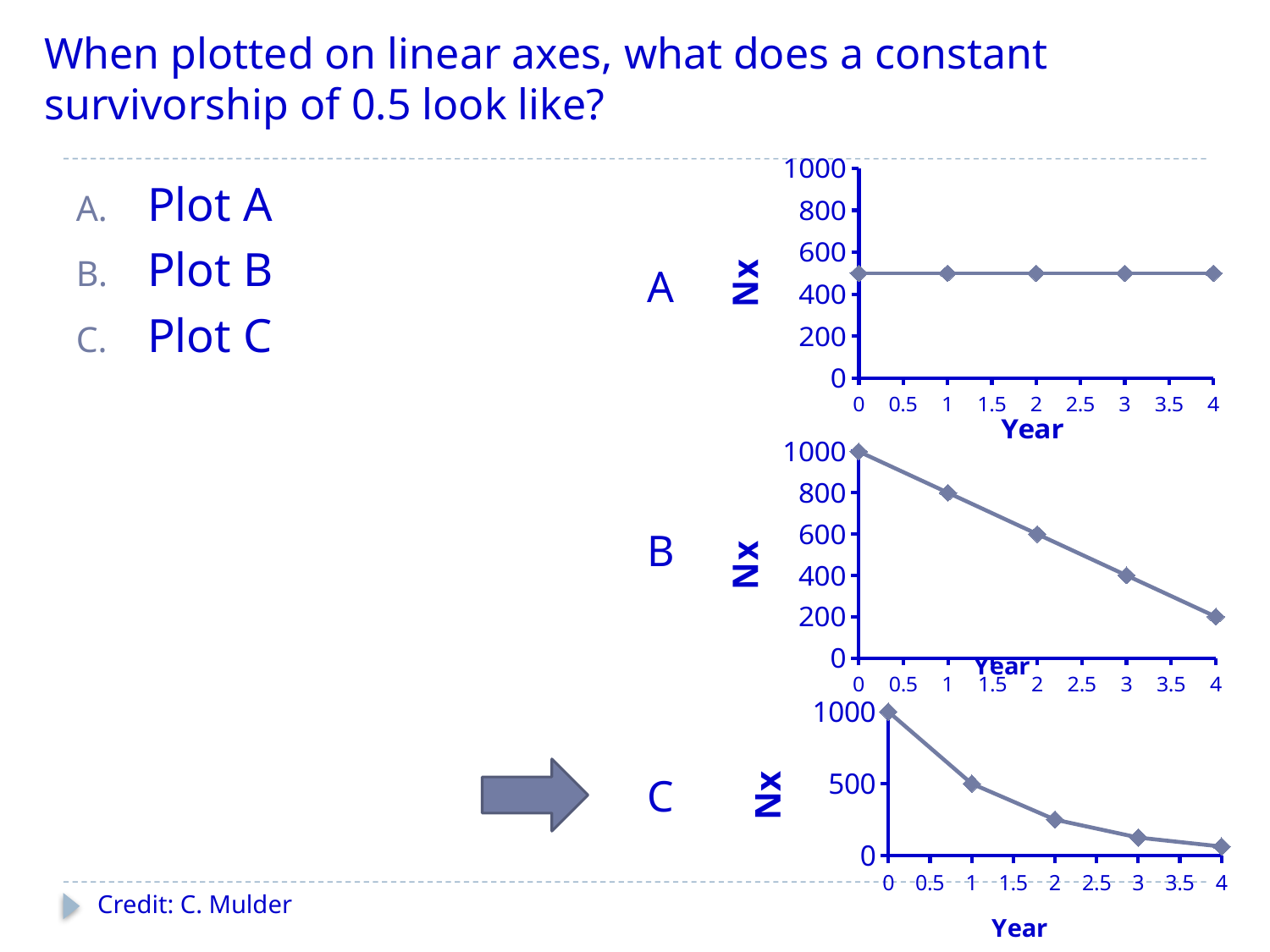
In Plot B, which year has the higher Nx value, year 1 or year 3? Year 1 In Plot A, is the value of Nx at year 2 greater or less than 400? greater How many data points are plotted in Plot C? 5 What kind of chart is Plot A? Line chart In Plot B, what is the value of Nx at year 2? 600 In Plot C, what is the difference between Nx at year 0 and Nx at year 1? 500 In Plot C, what is the value of Nx at year 1? 500 In Plot B, do the Nx values rise, fall, or stay flat as the year increases? Fall In Plot C, is the value of Nx at year 3 greater or less than 500? less In Plot B, what is the value of Nx at year 0? 1000 In Plot B, what is the value of Nx at year 4? 200 In Plot B, what is the difference between Nx at year 0 and Nx at year 4? 800